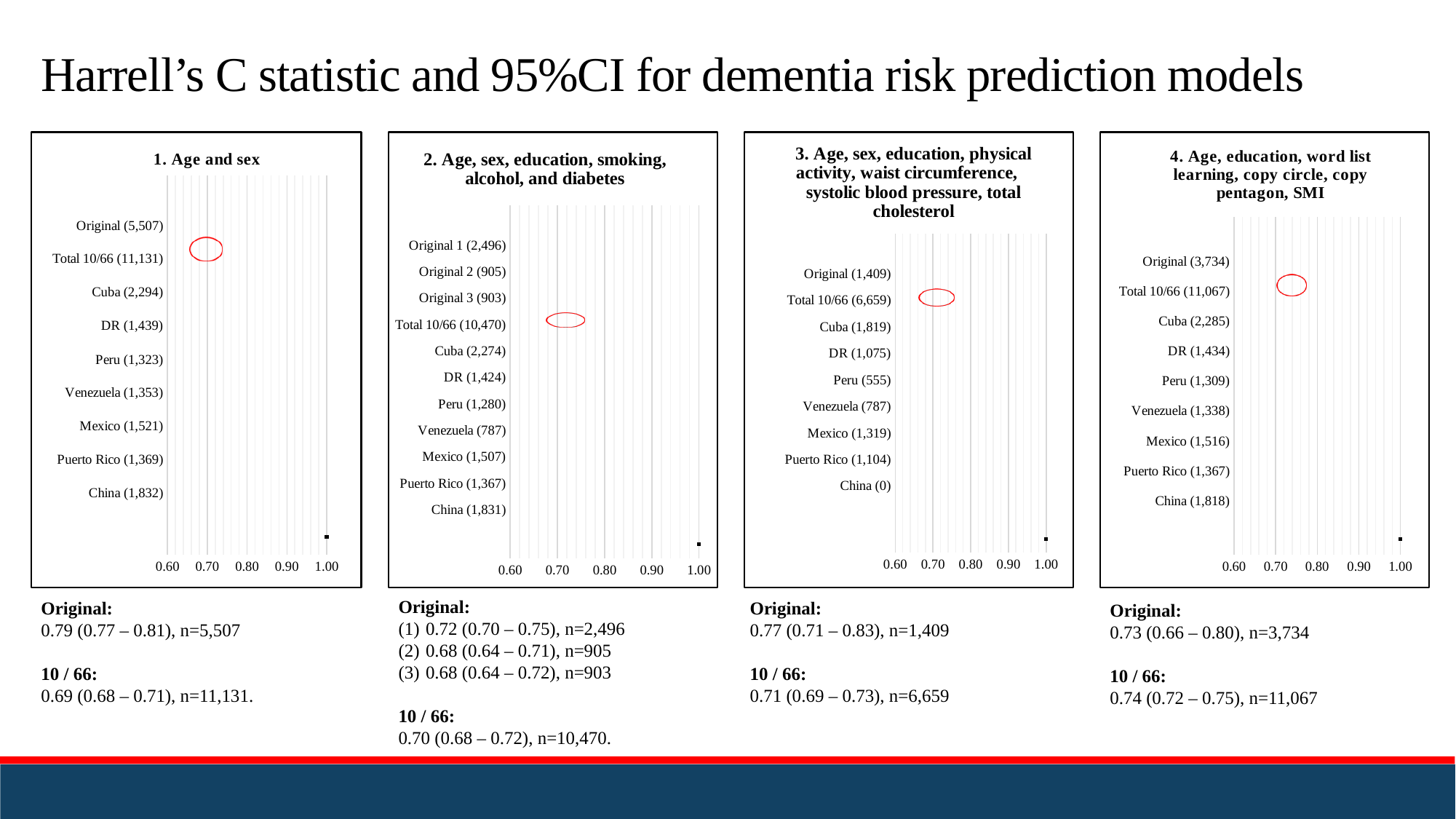
According to the text below the fourth chart, what is the Harrell's C statistic for the Original model? 0.73 How many charts are shown on the slide? 4 In the chart titled "2. Age, sex, education, smoking, alcohol, and diabetes", how many categories are listed on the vertical axis? 11 In the third chart ("3. Age, sex, education, physical activity..."), what sample size is shown in the label for China? 0 In the chart titled "4. Age, education, word list learning, copy circle, copy pentagon, SMI", what is the highest value shown on the horizontal axis? 1.00 According to the text below the chart titled "1. Age and sex", what is the Harrell's C statistic for the 10/66 model? 0.69 In the chart titled "4. Age, education, word list learning, copy circle, copy pentagon, SMI", what sample size is shown in the label for Puerto Rico? 1,367 In the chart titled "1. Age and sex", how many categories are listed on the vertical axis? 9 In the chart titled "2. Age, sex, education, smoking, alcohol, and diabetes", what sample size is shown in the label for Original 2? 905 In the chart titled "1. Age and sex", what is the lowest value shown on the horizontal axis? 0.60 In the chart titled "1. Age and sex", what sample size is shown in the label for Total 10/66? 11,131 According to the text below the third chart, what is the 95% CI for the 10/66 model? 0.69 – 0.73